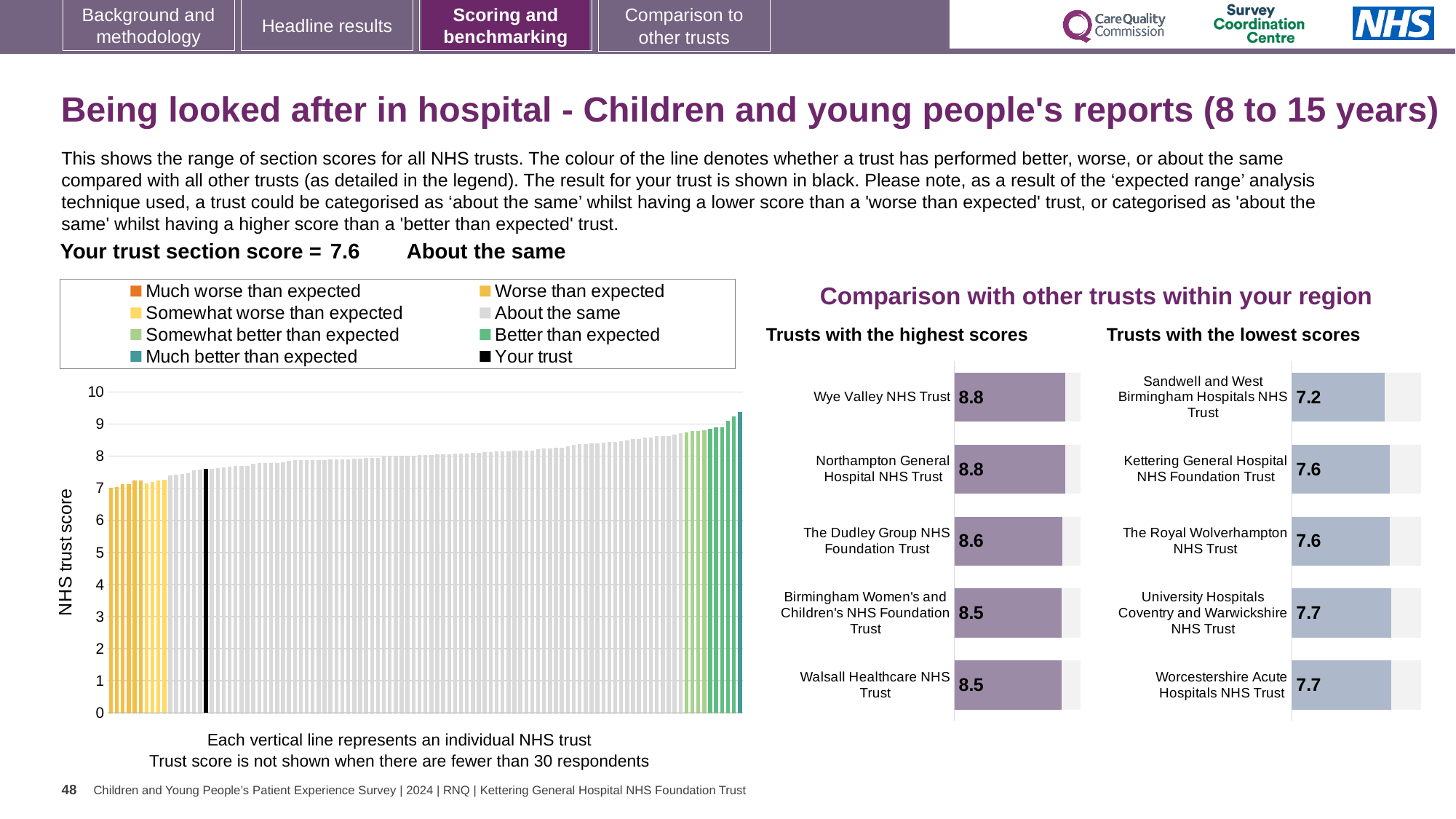
What kind of chart is the large 'NHS trust score' chart on the left? Bar chart In the large 'NHS trust score' chart on the left, do the values rise or fall from left to right? Rise In the 'Trusts with the lowest scores' chart, what is the difference between the scores of Worcestershire Acute Hospitals NHS Trust and Sandwell and West Birmingham Hospitals NHS Trust? 0.5 In the 'Trusts with the highest scores' chart, what is the score for Wye Valley NHS Trust? 8.8 In the 'Trusts with the lowest scores' chart, which trust has the lowest score? Sandwell and West Birmingham Hospitals NHS Trust In the 'Trusts with the lowest scores' chart, what is the score for Sandwell and West Birmingham Hospitals NHS Trust? 7.2 In the 'Trusts with the highest scores' chart, what is the score for The Dudley Group NHS Foundation Trust? 8.6 How many trusts are listed in the 'Trusts with the lowest scores' chart? 5 In the 'Trusts with the highest scores' chart, what is the difference between the scores of Wye Valley NHS Trust and The Dudley Group NHS Foundation Trust? 0.2 In the large 'NHS trust score' chart on the left, is the value for the black 'Your trust' bar greater or less than 8? less How many entries does the legend above the large 'NHS trust score' chart list? 8 In the 'Trusts with the highest scores' chart, which has the higher score: Northampton General Hospital NHS Trust or Walsall Healthcare NHS Trust? Northampton General Hospital NHS Trust